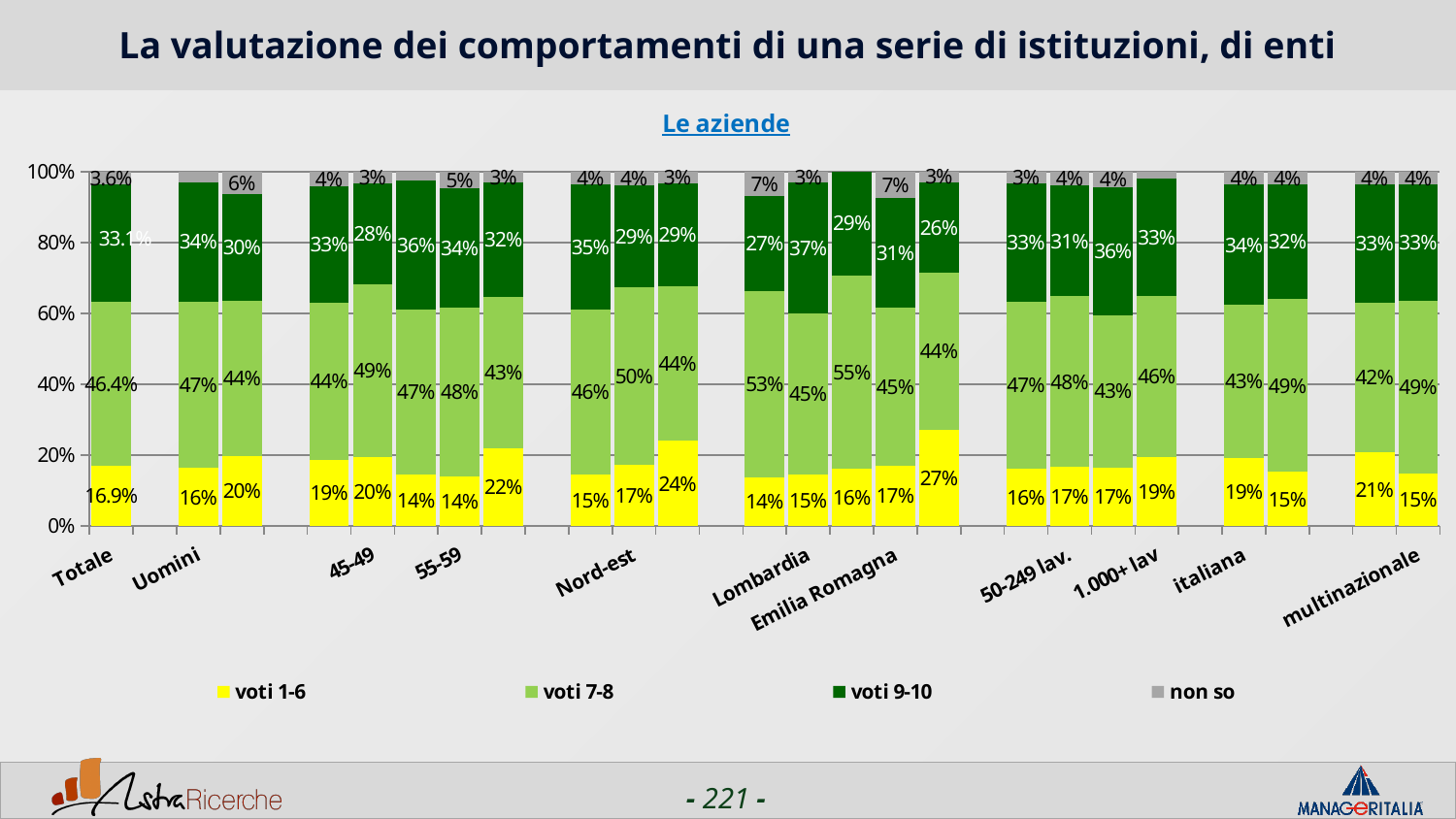
What is the value of 'voti 9-10' for Totale? 33.1% What is the value of 'voti 1-6' for Totale? 16.9% What is the value of 'voti 1-6' for 55-59? 14% What is the value of 'voti 9-10' for Lombardia? 37% What kind of chart is shown on the slide? stacked bar chart What is the subtitle shown above the chart? Le aziende Which has the larger 'voti 1-6' value, italiana or multinazionale? italiana For Totale, what is the difference between the 'voti 7-8' value and the 'voti 1-6' value? 29.5% What is the value of 'voti 7-8' for Nord-est? 50% What is the value of 'non so' for Emilia Romagna? 7% What is the value of 'non so' for Totale? 3.6% How many series does the legend list? 4